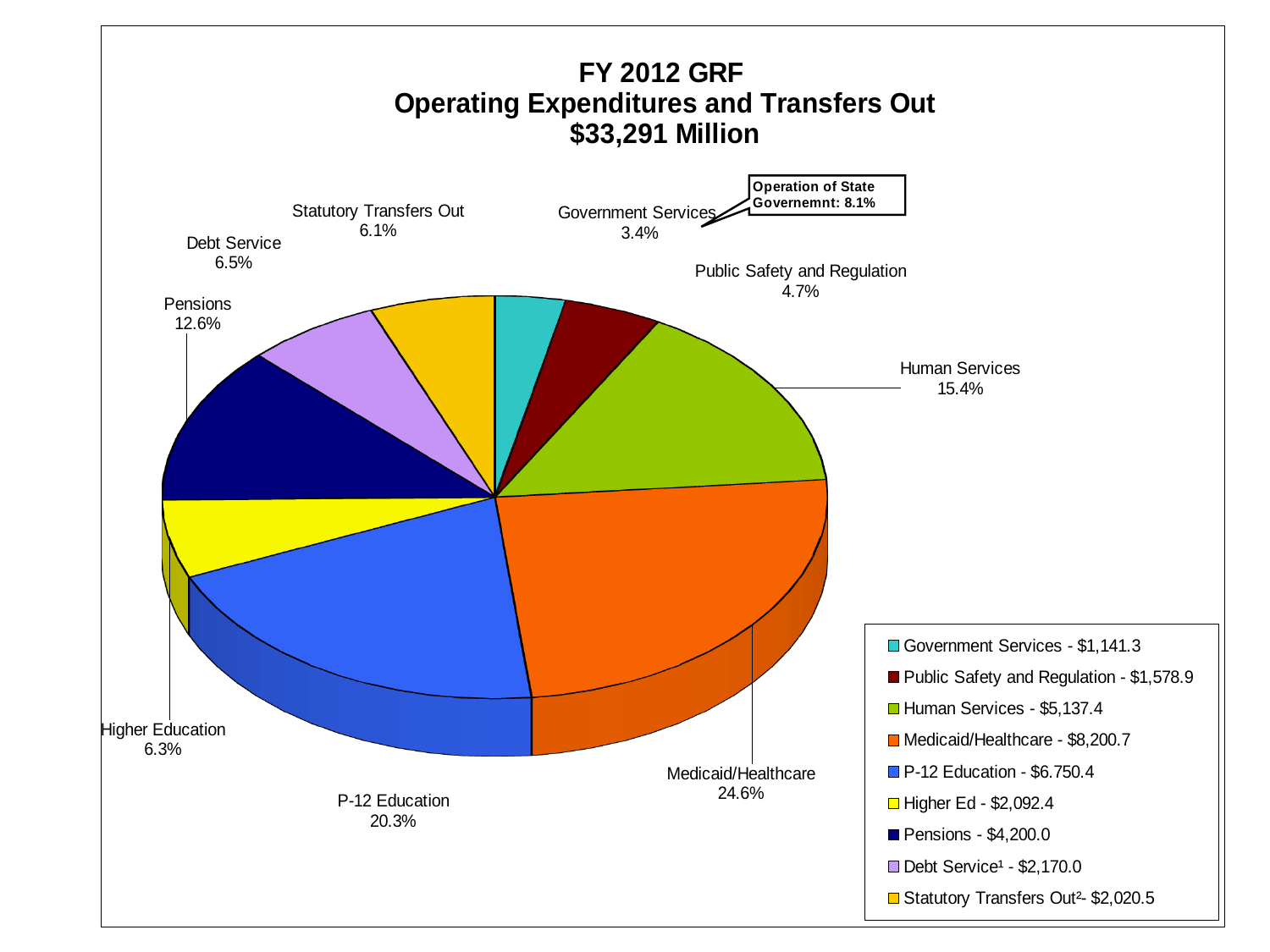
Which is larger, the share for Human Services or the share for Pensions? Human Services According to the legend, what is the dollar amount for Pensions? $4,200.0 How many categories are shown in the pie chart? 9 What percentage is shown for Human Services? 15.4% What share of the pie does Medicaid/Healthcare represent? 24.6% What is the difference in percentage points between Medicaid/Healthcare and P-12 Education? 4.3 percentage points What type of chart is shown on the slide? Pie chart What total amount is stated in the chart title? $33,291 Million Which category has the largest share of the pie? Medicaid/Healthcare What percentage does the callout box give for Operation of State Government? 8.1% What percentage is shown for P-12 Education? 20.3% Which category has the smallest share of the pie? Government Services